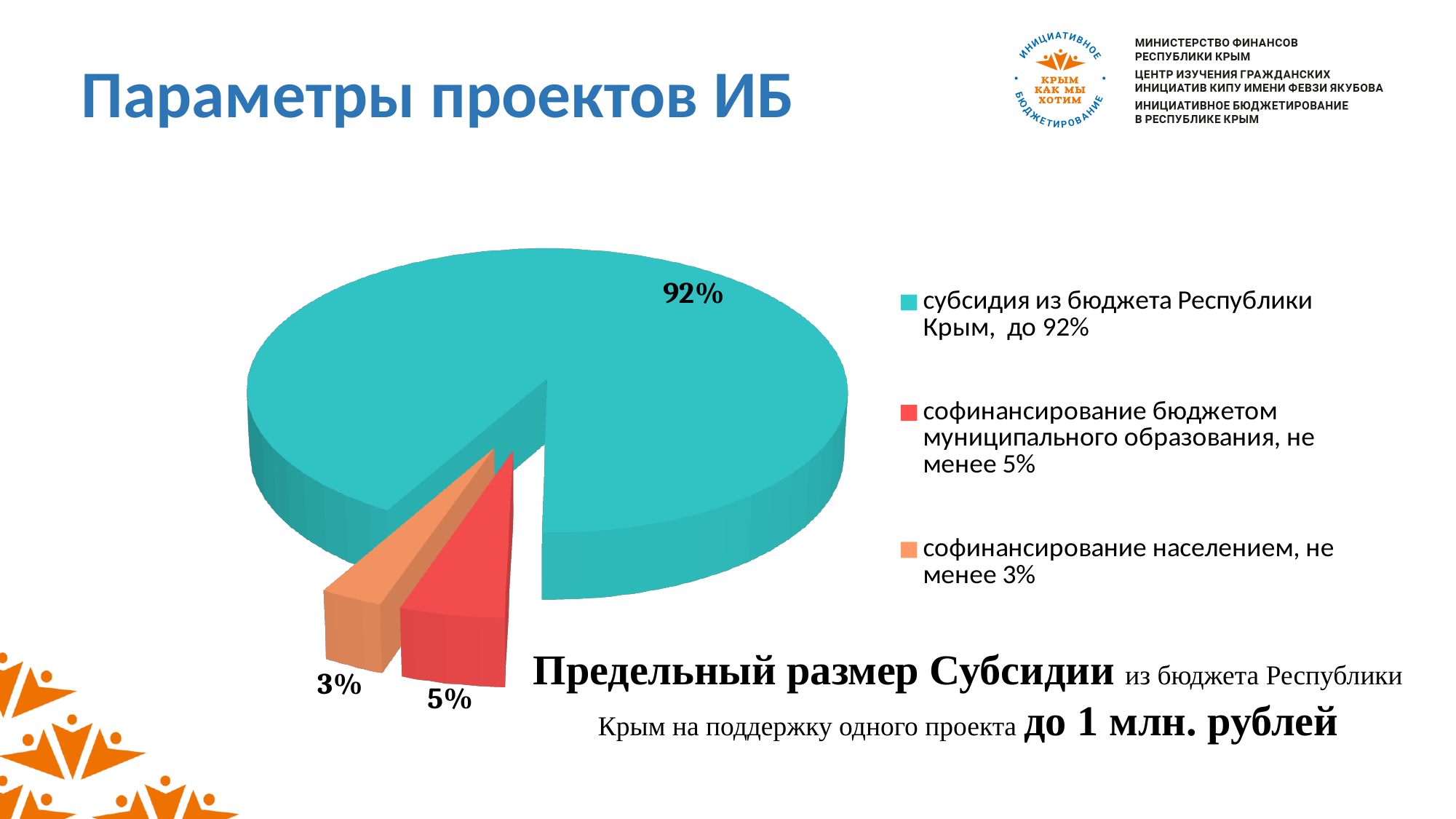
What kind of chart is shown on the slide? pie chart What share of the pie is labelled for the subsidy from the budget of the Republic of Crimea (субсидия из бюджета Республики Крым)? 92% Which slice of the pie chart is the smallest? софинансирование населением What share of the pie is labelled for co-financing by the municipal budget (софинансирование бюджетом муниципального образования)? 5% Which is larger: the share for municipal co-financing or the share for population co-financing? софинансирование бюджетом муниципального образования Which slice of the pie chart is the largest? субсидия из бюджета Республики Крым What share of the pie is labelled for co-financing by the population (софинансирование населением)? 3% What is the difference between the share for the Republic of Crimea subsidy and the share for municipal co-financing? 87% How many slices does the pie chart have? 3 What is the difference between the municipal co-financing share and the population co-financing share? 2% What colour is the slice representing the subsidy from the budget of the Republic of Crimea? teal How many entries does the legend of the pie chart list? 3